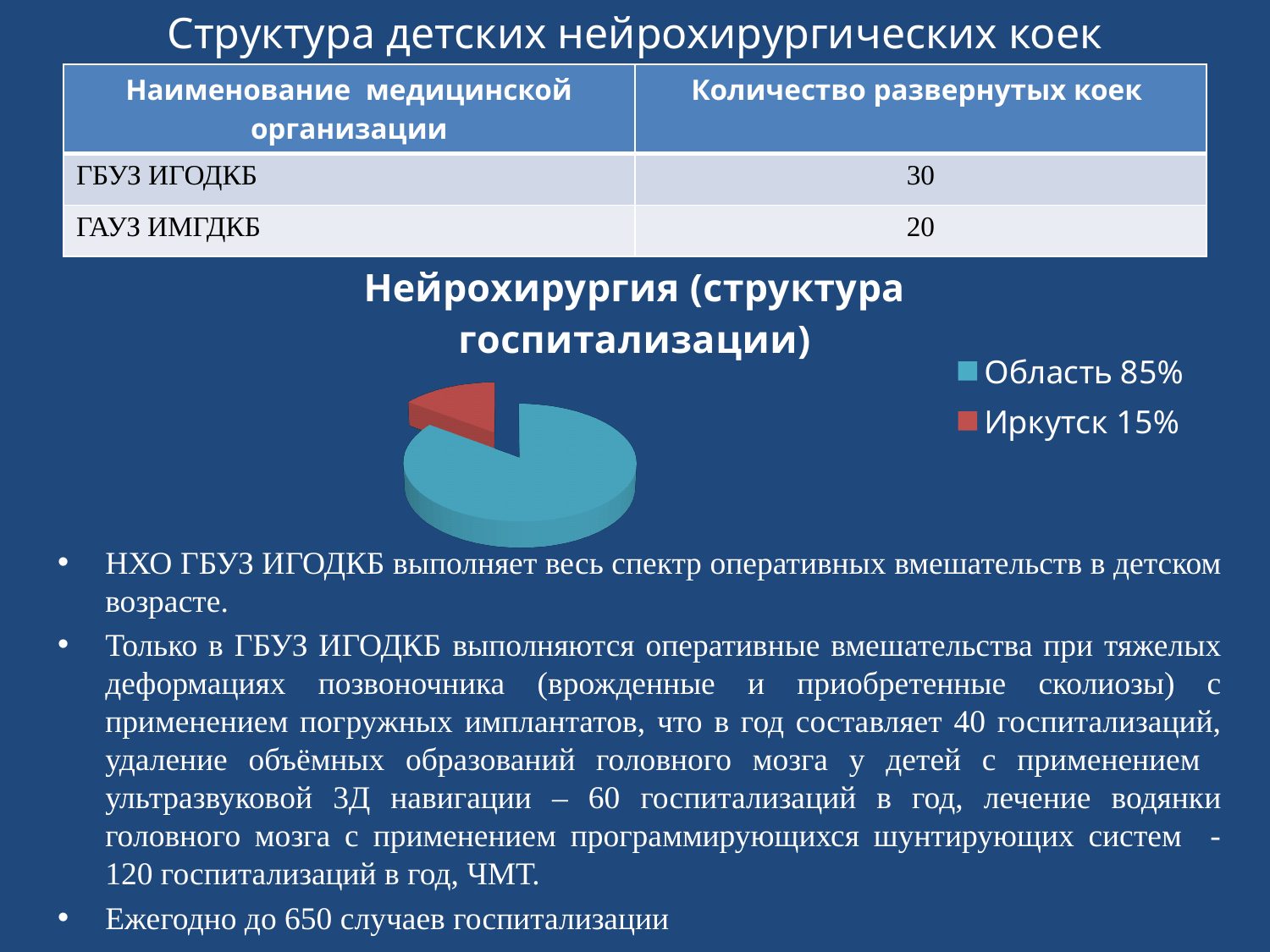
What colour is the "Иркутск" slice in the pie chart? red Which slice of the pie chart is the smallest? Иркутск By how many percentage points does the "Область" share exceed the "Иркутск" share in the pie chart? 70 Which slice of the pie chart is the largest? Область How many entries does the legend of the pie chart list? 2 What share of the pie chart does "Область" account for? 85% What share of the pie chart does "Иркутск" account for? 15% What kind of chart is shown under the title "Нейрохирургия (структура госпитализации)"? pie chart What is the title of the pie chart on the slide? Нейрохирургия (структура госпитализации) How many slices does the pie chart have? 2 In the pie chart, which is larger: the share for "Область" or the share for "Иркутск"? Область